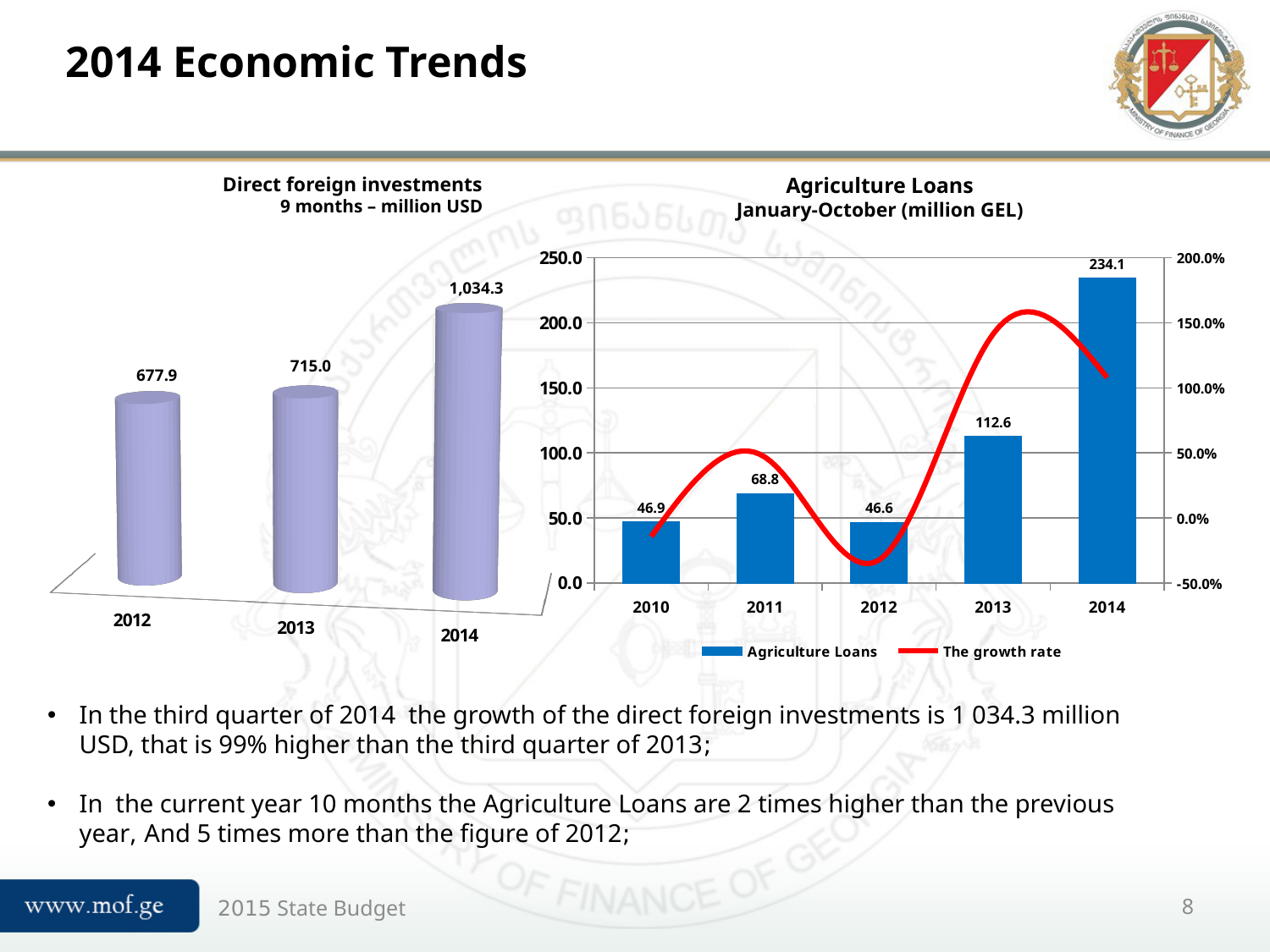
In the Agriculture Loans chart, how many series does the legend list? 2 In the Agriculture Loans chart, what is the difference between the Agriculture Loans values for 2014 and 2013? 121.5 In the Direct foreign investments chart, what is the difference between the 2013 and 2012 values? 37.1 In the Agriculture Loans chart, which year has the lowest Agriculture Loans value? 2012 In the Direct foreign investments chart, what is the value for 2014? 1,034.3 In the Direct foreign investments chart, do the values rise or fall from 2012 to 2014? rise In the Direct foreign investments chart, what is the value for 2012? 677.9 In the Agriculture Loans chart, what is the Agriculture Loans value for 2013? 112.6 In the Agriculture Loans chart, which year has the highest Agriculture Loans value? 2014 In the Agriculture Loans chart, what colour is the growth rate line? red In the Agriculture Loans chart, is the growth rate for 2013 greater or less than 100.0%? greater In the Direct foreign investments chart, how many years are shown? 3